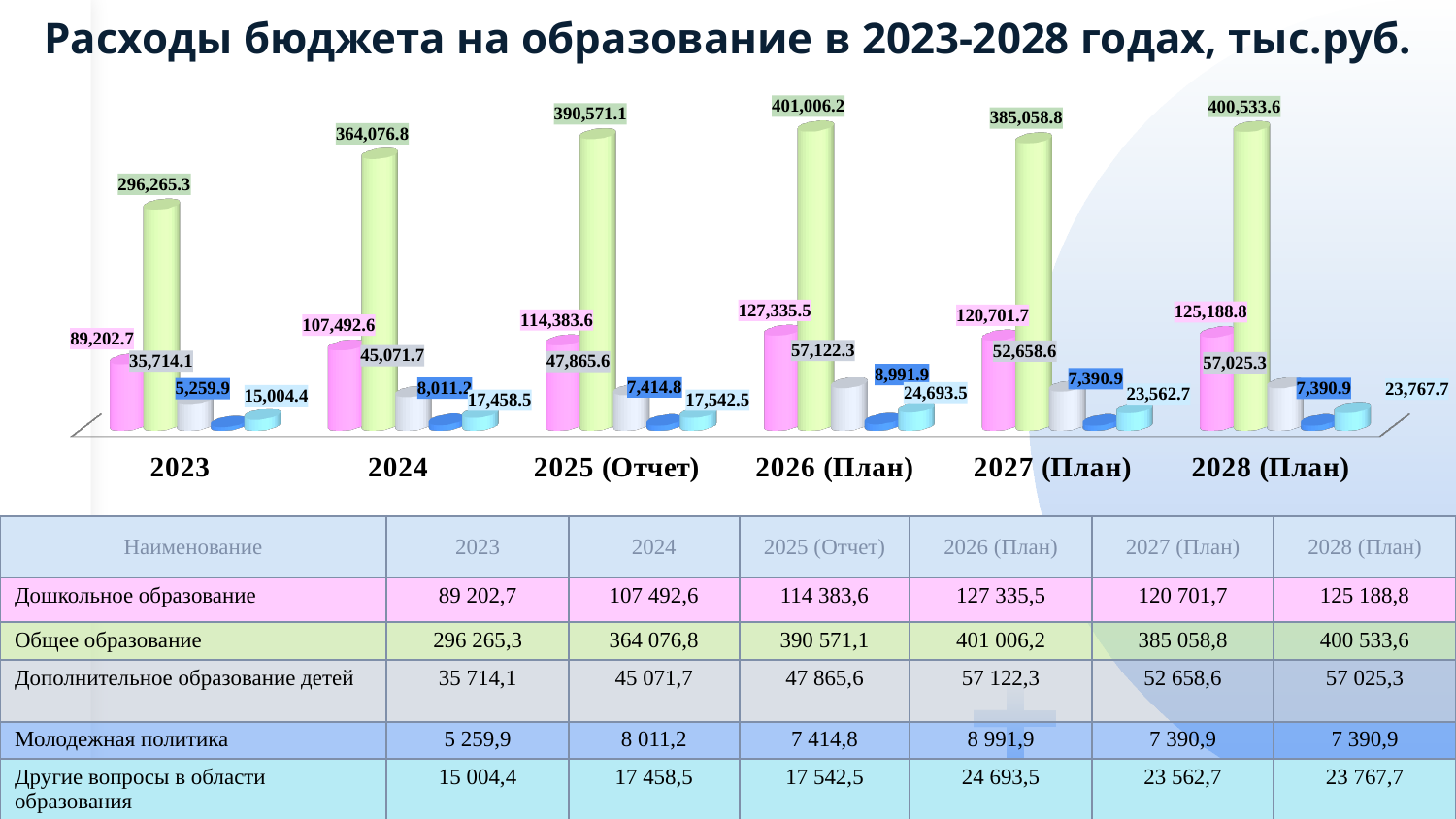
What value is shown for Молодежная политика in 2024? 8,011.2 In which year is the value for Дошкольное образование the lowest? 2023 What value is shown for Общее образование in 2023? 296,265.3 How many year categories are shown on the x axis of the chart? 6 What is the difference between the Общее образование values for 2024 and 2023? 67,811.5 In which year is the value for Общее образование the highest? 2026 (План) What is the title of the chart? Расходы бюджета на образование в 2023-2028 годах, тыс.руб. What is the data label on the tallest bar for 2026 (План)? 401,006.2 How many data series are plotted for each year in the chart? 5 Which is larger: Дополнительное образование детей in 2026 (План) or in 2027 (План)? 2026 (План) What value is shown for Дошкольное образование in 2025 (Отчет)? 114,383.6 What type of chart is shown on the slide? Bar chart